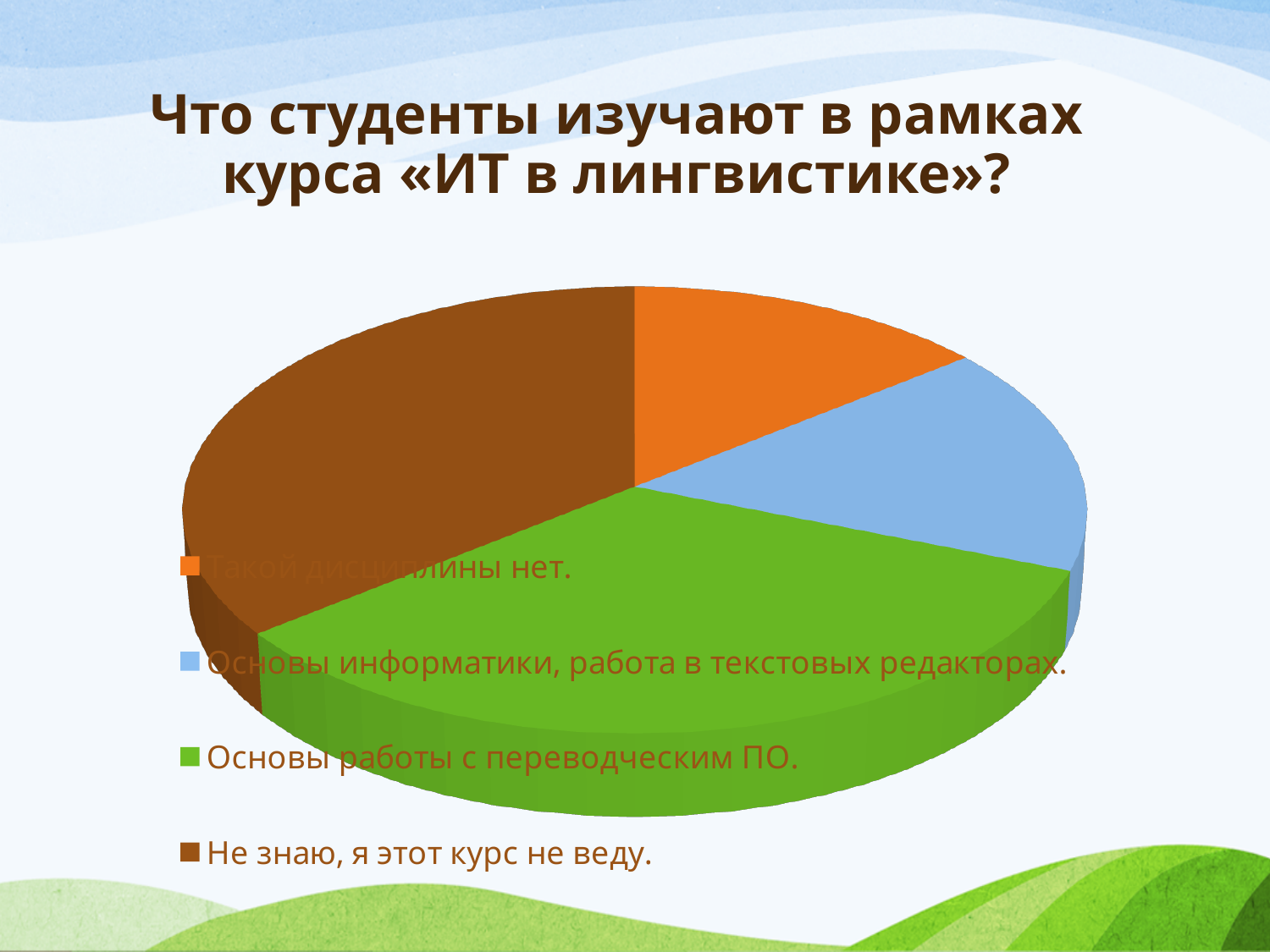
Which slice is larger: "Не знаю, я этот курс не веду." or "Такой дисциплины нет."? Не знаю, я этот курс не веду. Which slice is larger: "Не знаю, я этот курс не веду." or "Основы информатики, работа в текстовых редакторах."? Не знаю, я этот курс не веду. What kind of chart is shown on the slide? pie chart How many slices does the pie chart have? 4 What is the title of the slide with the pie chart? Что студенты изучают в рамках курса «ИТ в лингвистике»? Which slice is larger: "Основы работы с переводческим ПО." or "Основы информатики, работа в текстовых редакторах."? Основы работы с переводческим ПО. Which legend entry is shown in green on the pie chart? Основы работы с переводческим ПО. How many entries does the legend of the pie chart list? 4